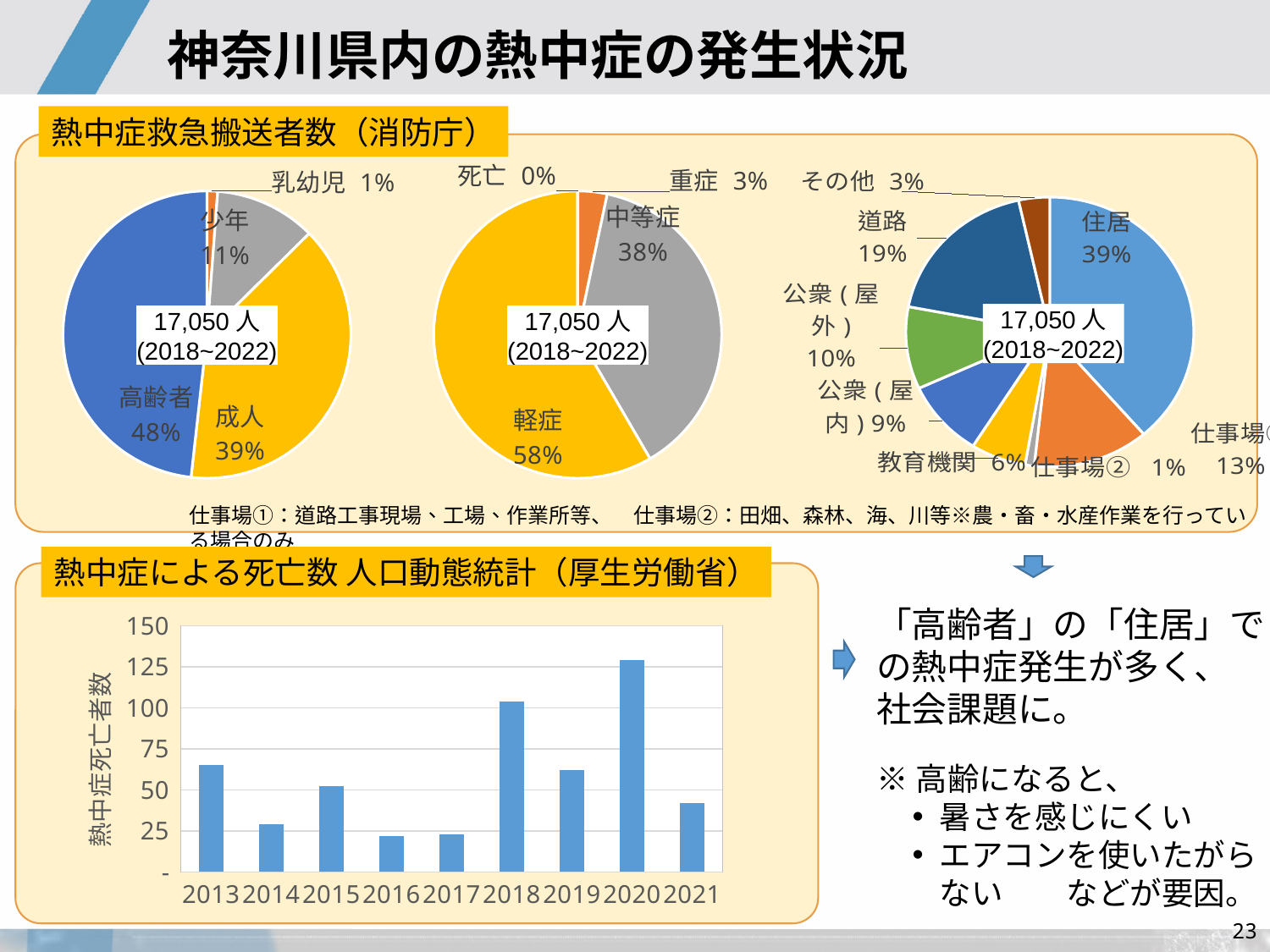
In the left pie chart (age groups), what is the difference in percentage points between 高齢者 and 少年? 37 In the left pie chart (age groups), what share is 成人? 39% In the right pie chart (location), how many categories are shown? 8 In the right pie chart (location), what share is 道路? 19% In the middle pie chart (severity), what share is 軽症? 58% In the left pie chart (age groups), which category has the largest share? 高齢者 In the bar chart of heatstroke deaths, which year has the highest value? 2020 In the middle pie chart (severity), which is larger, 中等症 or 重症? 中等症 In the bar chart of heatstroke deaths, how many years are shown on the x axis? 9